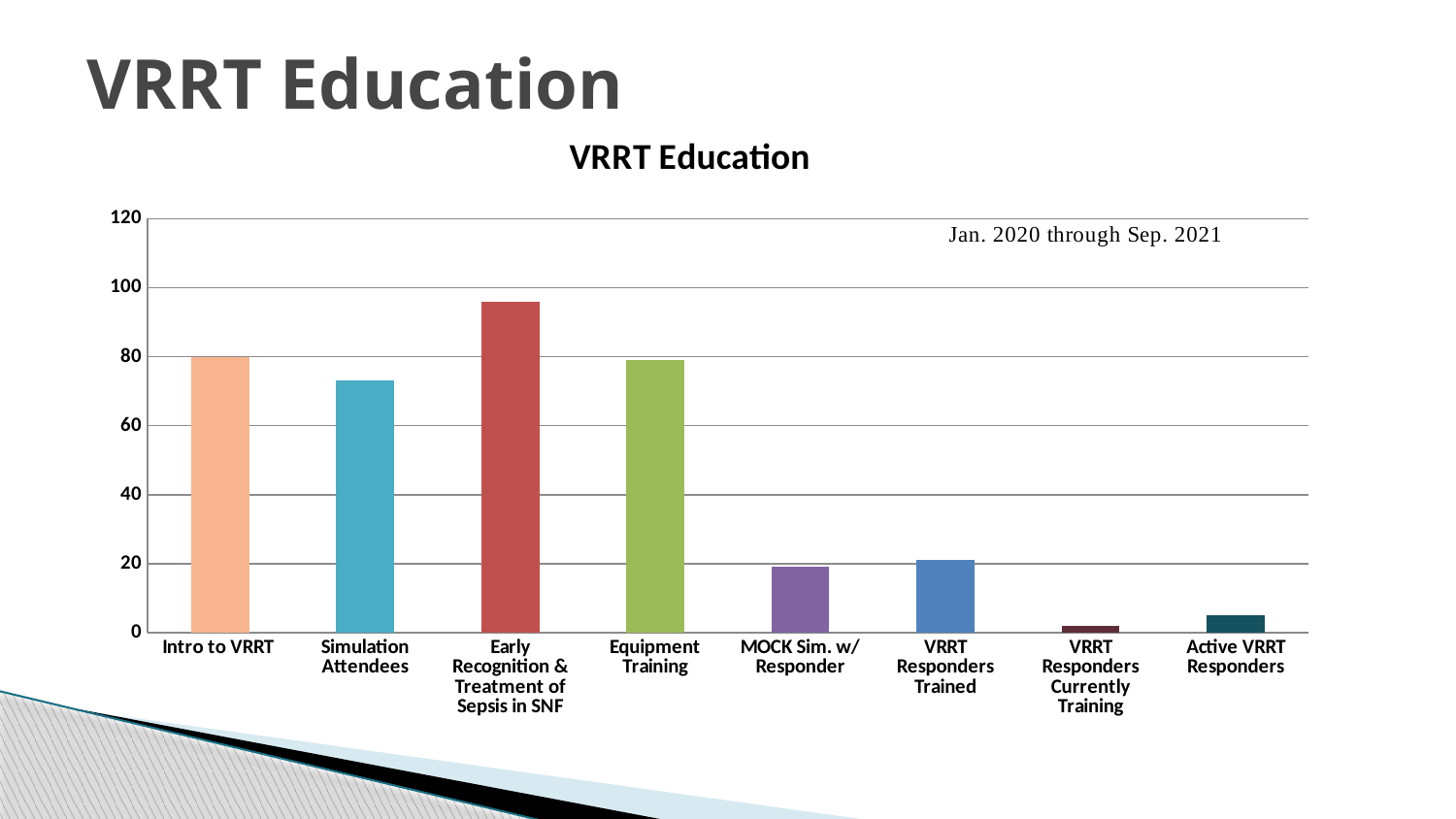
What kind of chart is shown on the slide? bar chart Is the value for Active VRRT Responders greater or less than 20? less Is the value for Early Recognition & Treatment of Sepsis in SNF greater or less than 100? less What time period does the text in the chart area say the data covers? Jan. 2020 through Sep. 2021 Is the value for Simulation Attendees greater or less than 60? greater How many categories are shown on the x axis of the chart? 8 Which is larger, the value for Intro to VRRT or the value for Simulation Attendees? Intro to VRRT Which category has the lowest bar? VRRT Responders Currently Training What is the title of the chart? VRRT Education Which category has the highest bar? Early Recognition & Treatment of Sepsis in SNF Which is larger, the value for Early Recognition & Treatment of Sepsis in SNF or the value for Equipment Training? Early Recognition & Treatment of Sepsis in SNF